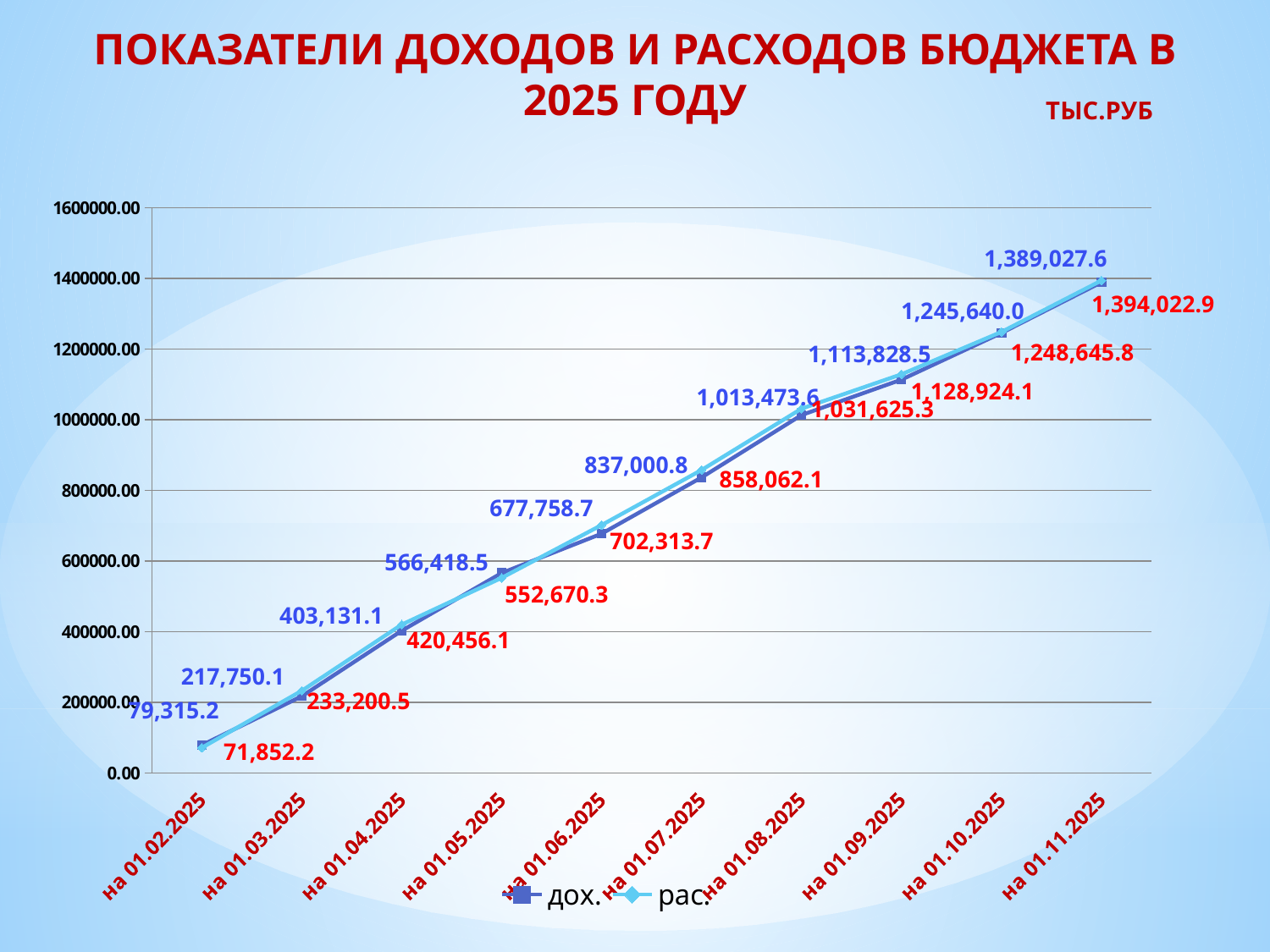
What is the difference between the рас. and дох. values on 01.11.2025? 4,995.3 What is the value of the рас. series on 01.11.2025? 1,394,022.9 On which date does the дох. series reach its highest value? на 01.11.2025 What kind of chart is shown on the slide? line chart What is the value of the дох. series on 01.02.2025? 79,315.2 What is the value of the дох. series on 01.07.2025? 837,000.8 How many series does the legend list? 2 Which series has the larger value on 01.05.2025, дох. or рас.? дох. What is the value of the рас. series on 01.04.2025? 420,456.1 How many dates are plotted on the x axis? 10 What is the difference between the рас. and дох. values on 01.07.2025? 21,061.3 On which date is the рас. series at its lowest value? на 01.02.2025